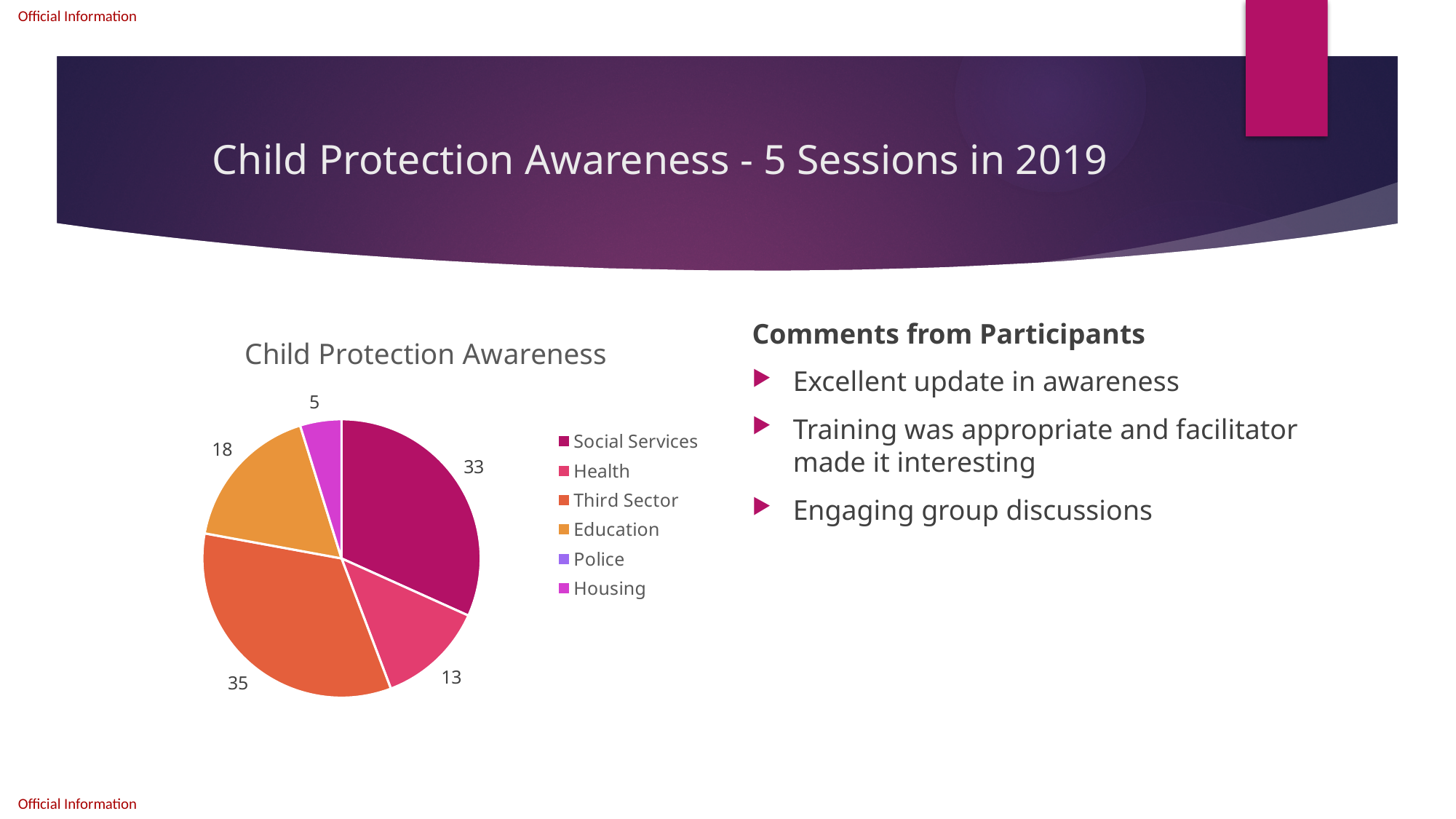
Which is larger, the value for Education or the value for Health? Education Which category has the largest slice in the pie chart? Third Sector What is the value for Third Sector in the pie chart? 35 What is the value for Health in the pie chart? 13 Which labelled slice in the pie chart has the smallest value? Housing What type of chart is shown on the slide? pie chart How many categories does the chart legend list? 6 What is the value for Housing in the pie chart? 5 What is the value for Education in the pie chart? 18 What is the title of the chart? Child Protection Awareness What is the value for Social Services in the pie chart? 33 What is the difference between the values for Third Sector and Health? 22